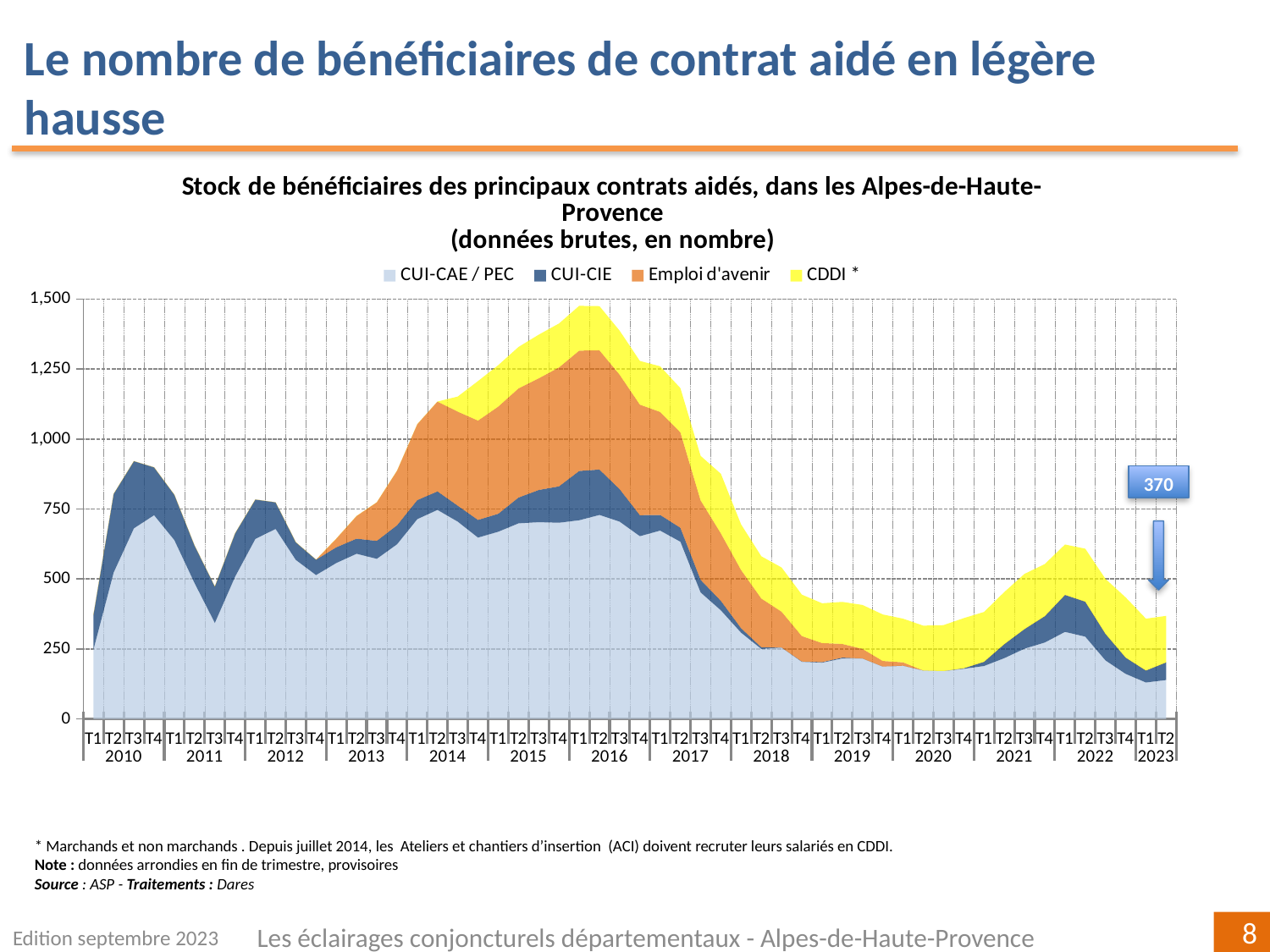
Does the total stock of beneficiaries rise or fall between T1 2016 and T1 2020? fall What kind of chart is shown on the slide? stacked area chart Is the total stock of beneficiaries at T1 2010 greater or less than 500? less What value is shown in the callout label for the most recent quarter (T2 2023)? 370 In which year does the total stock of beneficiaries reach its highest point? 2016 Which series is listed first in the legend? CUI-CAE / PEC Is the total stock of beneficiaries at T1 2016 greater or less than 1,250? greater Is the total stock of beneficiaries at T2 2023 greater or less than 500? less What is the first year shown on the x axis? 2010 How many series does the legend list? 4 Which series is shown in yellow? CDDI * Which is larger, the total stock of beneficiaries at T1 2016 or at T2 2023? T1 2016